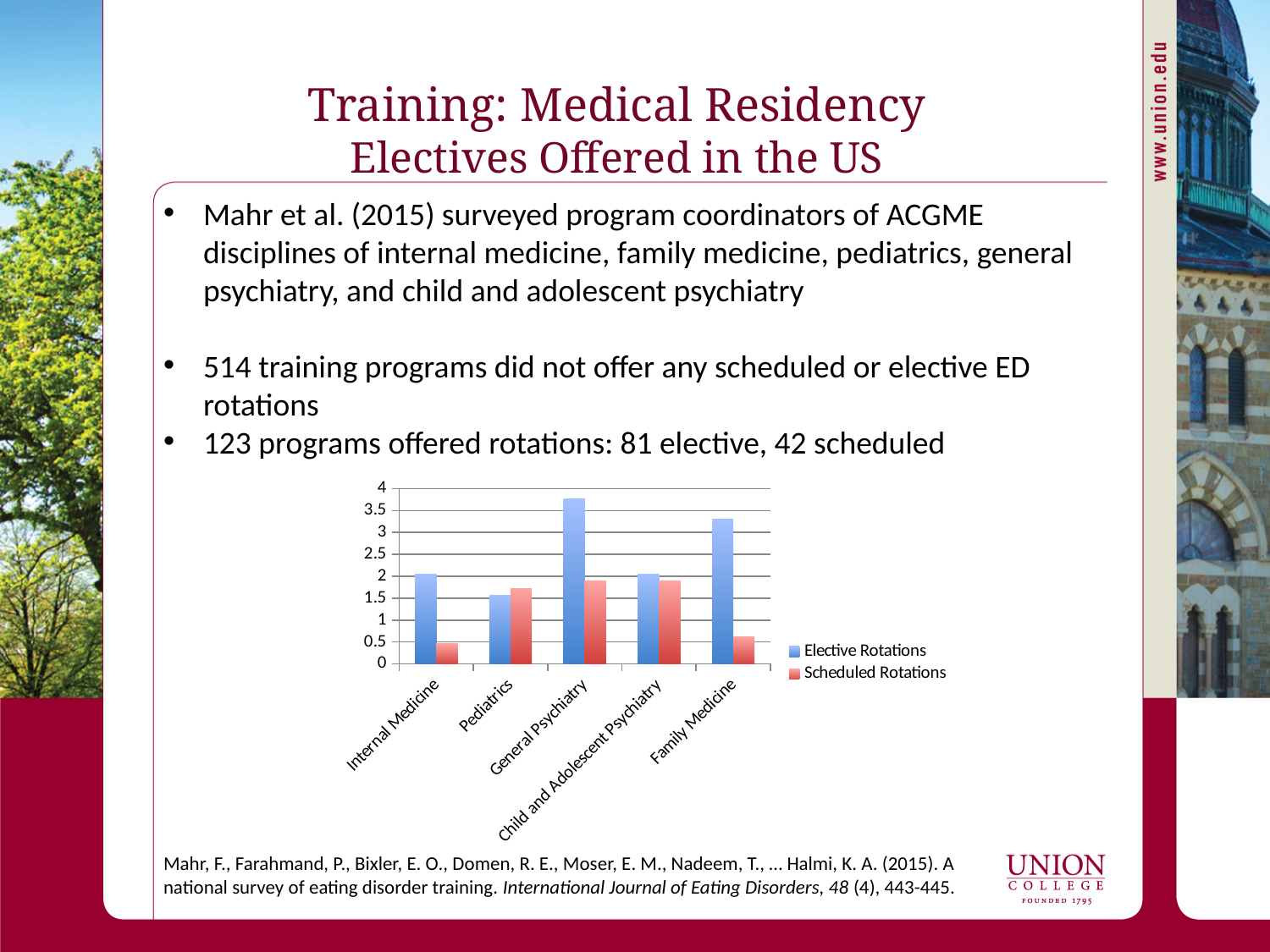
Which category has the highest value for Elective Rotations? General Psychiatry For General Psychiatry, which is larger: Elective Rotations or Scheduled Rotations? Elective Rotations Is the Elective Rotations value for General Psychiatry greater or less than 3.5? greater Which category has the lowest value for Elective Rotations? Pediatrics How many categories are shown on the x axis of the chart? 5 Is the Elective Rotations value for Family Medicine greater or less than 3? greater Is the Elective Rotations value for Pediatrics greater or less than 2? less Which has the larger Elective Rotations value: Internal Medicine or Family Medicine? Family Medicine What colour are the Scheduled Rotations bars in the chart? red What kind of chart is shown on the slide? bar chart How many series does the chart's legend list? 2